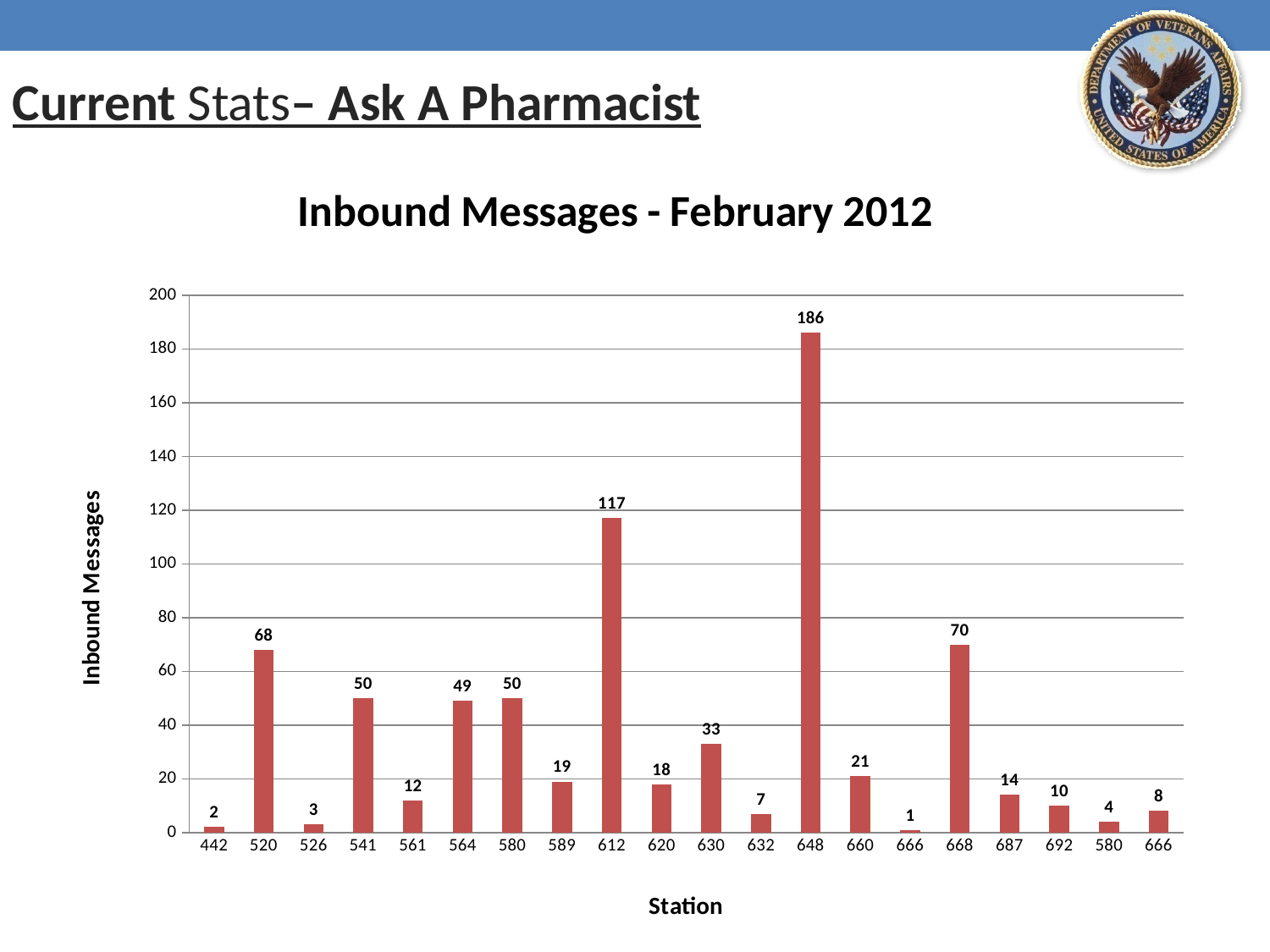
How many inbound messages did station 520 receive? 68 What is the label of the y axis of the chart? Inbound Messages What is the difference in inbound messages between station 648 and station 612? 69 What is the title of the chart? Inbound Messages - February 2012 How many inbound messages did station 612 receive? 117 How many stations are shown on the x axis of the chart? 20 What type of chart is shown on the slide? bar chart What is the difference in inbound messages between station 668 and station 520? 2 Which station has more inbound messages, 630 or 660? 630 How many inbound messages did station 648 receive? 186 Which station has more inbound messages, 541 or 564? 541 Which station has the highest number of inbound messages? 648